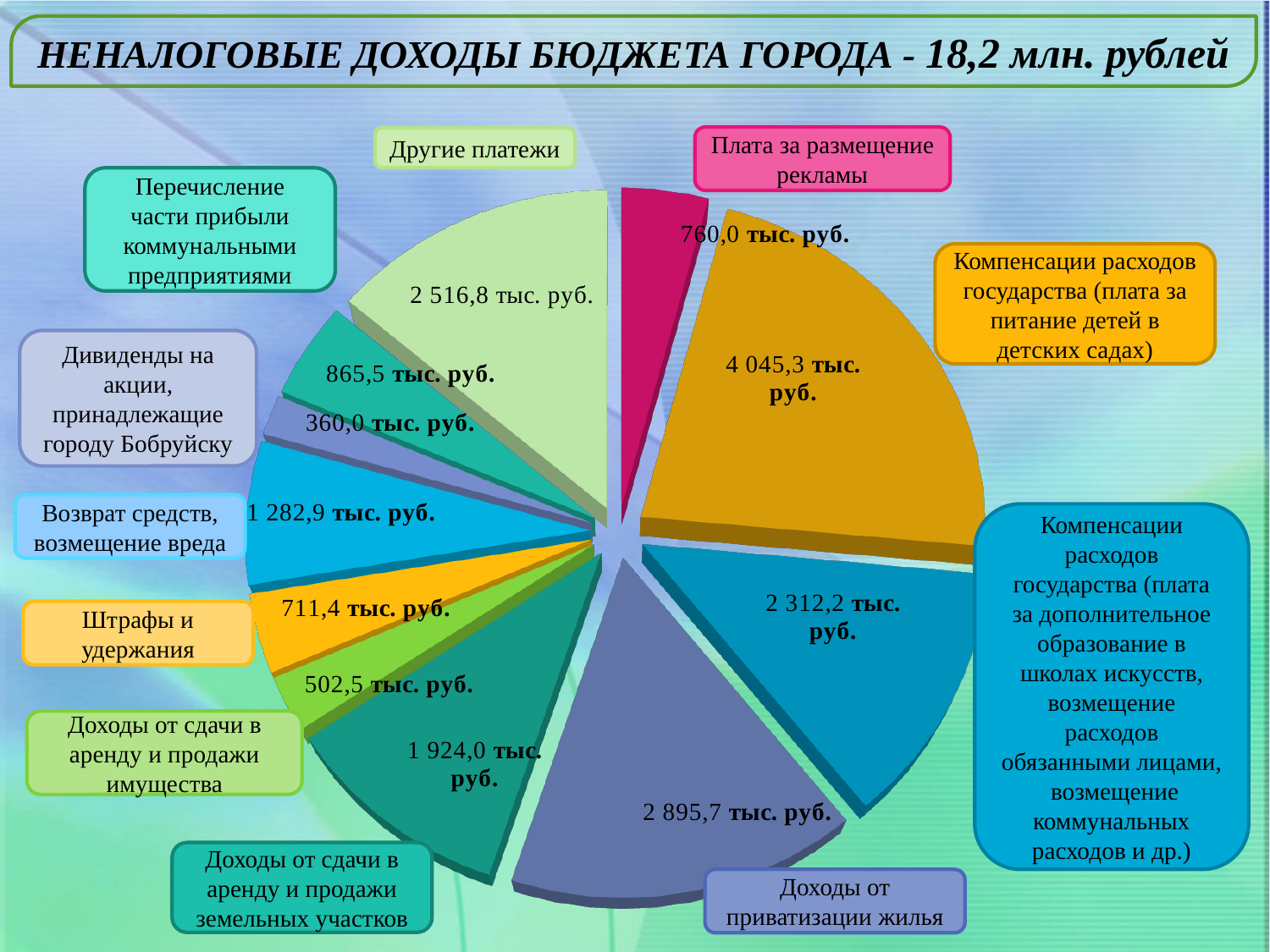
What is the difference between the value for «Перечисление части прибыли коммунальными предприятиями» and the value for «Дивиденды на акции, принадлежащие городу Бобруйску»? 505,5 тыс. руб. What kind of chart is shown on the slide? Pie chart What is the value for «Плата за размещение рекламы»? 760,0 тыс. руб. Which is larger: the value for «Доходы от сдачи в аренду и продажи земельных участков» or the value for «Возврат средств, возмещение вреда»? Доходы от сдачи в аренду и продажи земельных участков Which category has the smallest value in the pie chart? Дивиденды на акции, принадлежащие городу Бобруйску How many categories (slices) does the pie chart have? 11 What is the value for «Другие платежи»? 2 516,8 тыс. руб. Which category has the largest value in the pie chart? Компенсации расходов государства (плата за питание детей в детских садах) What is the difference between the value for «Компенсации расходов государства (плата за питание детей в детских садах)» and the value for «Доходы от приватизации жилья»? 1 149,6 тыс. руб. What total amount of non-tax budget revenue is stated in the chart title? 18,2 млн. рублей What is the value for «Штрафы и удержания»? 711,4 тыс. руб. What is the value for «Доходы от приватизации жилья»? 2 895,7 тыс. руб.